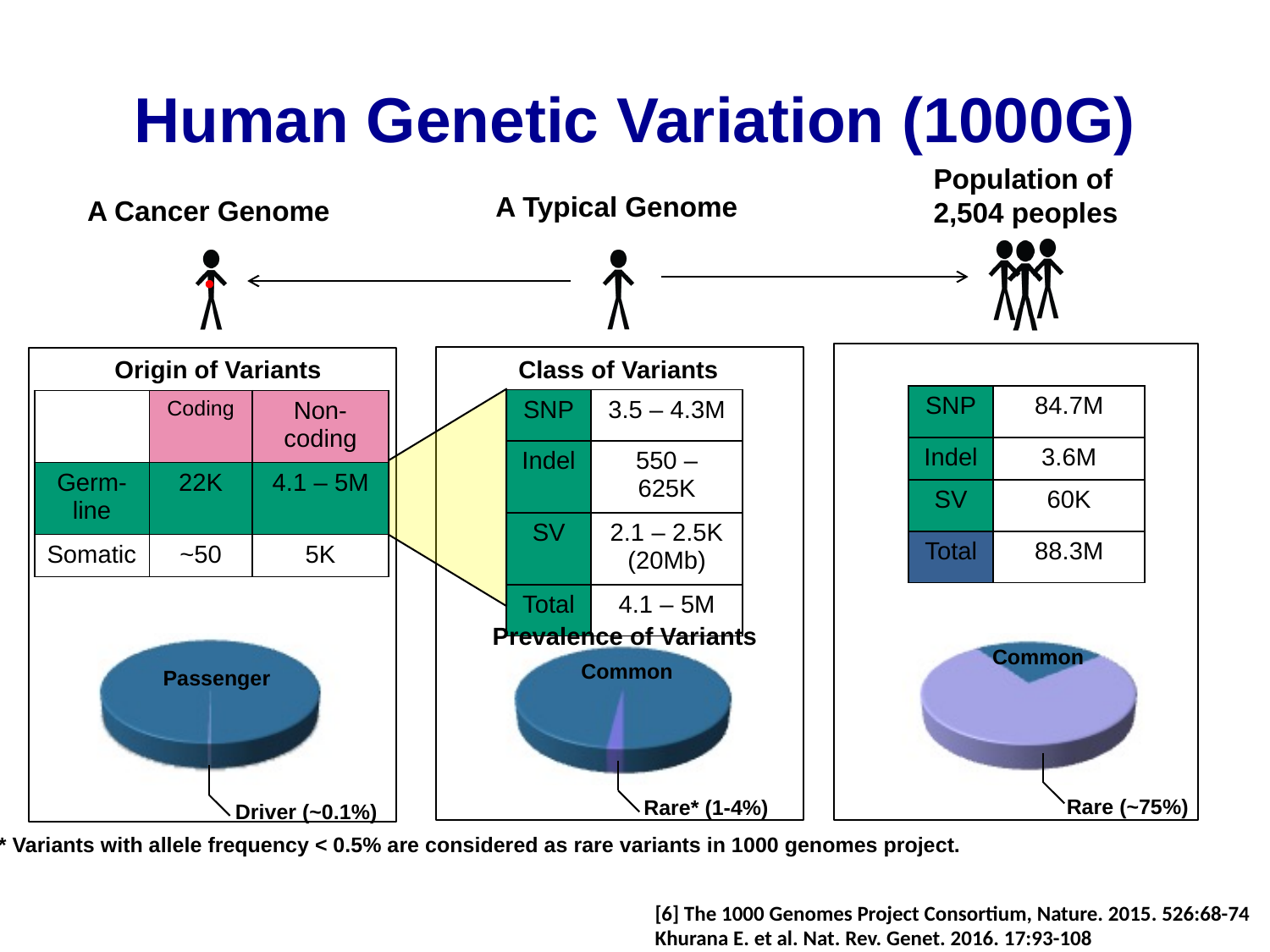
In the pie chart under "A Cancer Genome", which slice is the largest? Passenger What is the full label of the smaller slice in the pie chart under "A Cancer Genome"? Driver (~0.1%) In the pie chart under "Population of 2,504 peoples" on the right, which slice is the largest? Rare How many slices does the pie chart under "A Cancer Genome" have? 2 What is the title printed above the middle pie chart? Prevalence of Variants In the pie chart under "Population of 2,504 peoples" on the right, which slice is the smallest? Common In the pie chart under "A Cancer Genome", which slice is the smallest? Driver In the pie chart on the right of the slide, which slice is larger, Common or Rare? Rare How many pie charts are shown on the slide? 3 In the "Prevalence of Variants" pie chart in the middle of the slide, which slice is the smallest? Rare* What kind of chart is shown under "A Cancer Genome" at the bottom left of the slide? pie chart In the "Prevalence of Variants" pie chart in the middle of the slide, which slice is the largest? Common